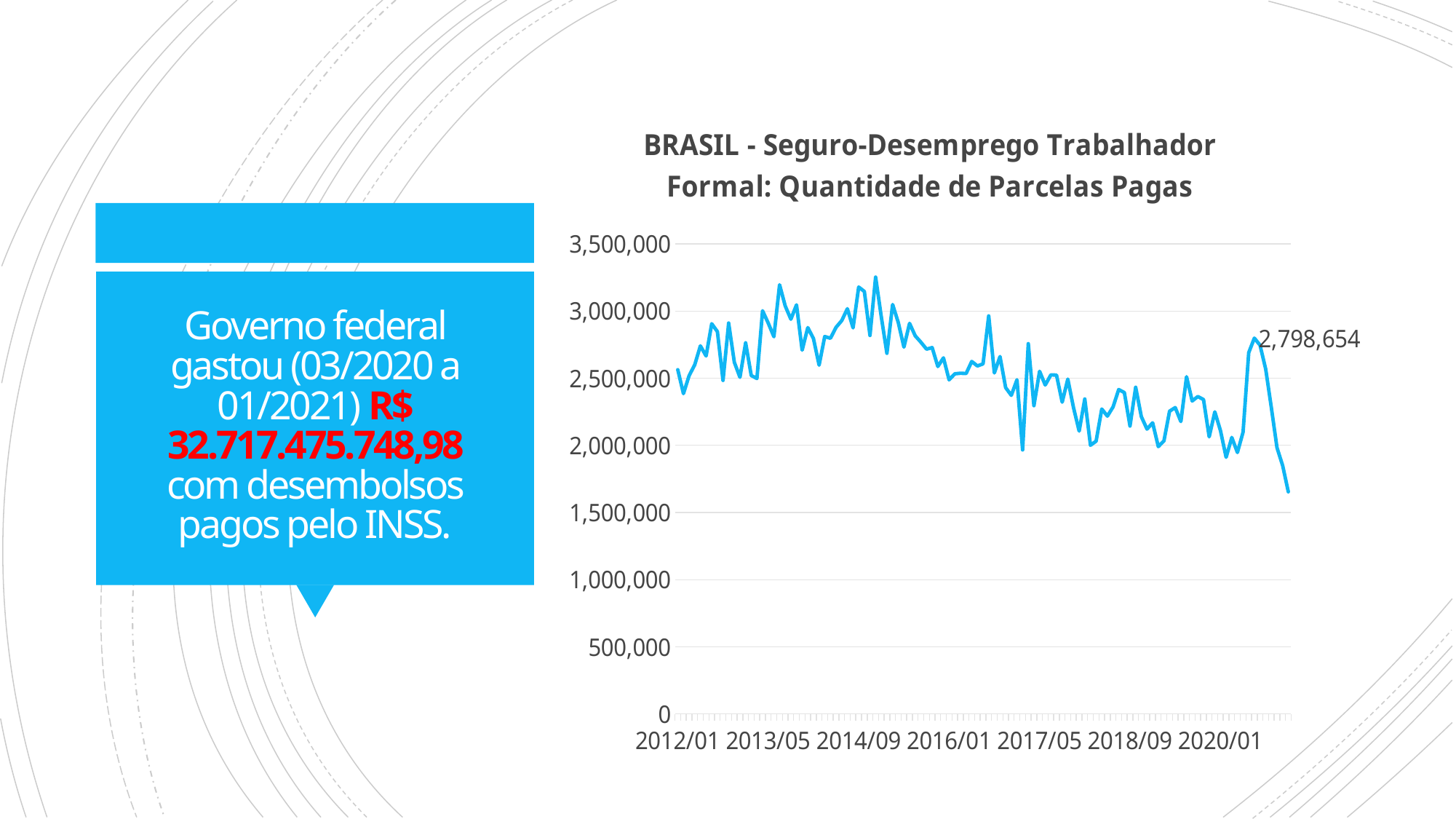
Is the highest point of the line, reached around 2014/09, greater or less than 3,000,000? greater Is the final value of the series (at the right end of the line) greater or less than 2,000,000? less What is the title of the chart? BRASIL - Seguro-Desemprego Trabalhador Formal: Quantidade de Parcelas Pagas What kind of chart is shown on the slide? line chart Overall, do the values rise or fall from the left end of the x axis to the right end? fall Is the value at the start of the series (2012/01) greater or less than 2,000,000? greater What value is printed as a data label on the line chart? 2,798,654 How many date labels are shown along the x axis? 7 What is the highest value shown on the y axis? 3,500,000